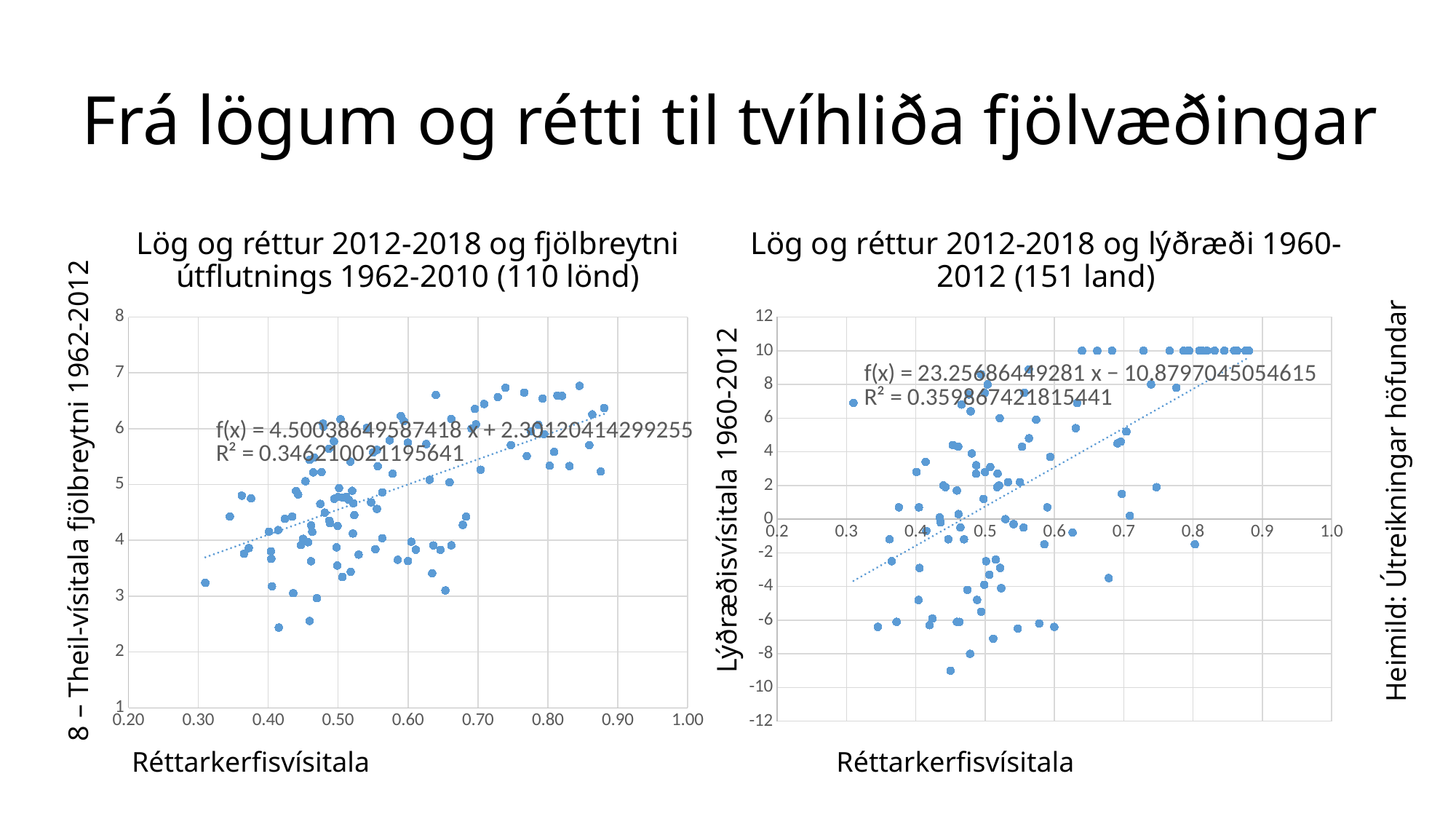
What kind of chart is the left chart, 'Lög og réttur 2012-2018 og fjölbreytni útflutnings 1962-2010 (110 lönd)'? Scatter chart What kind of chart is the right chart, 'Lög og réttur 2012-2018 og lýðræði 1960-2012 (151 land)'? Scatter chart In the right chart, what is the R² value shown for the trendline? R² = 0.359867421815441 Which chart has the higher R² value, the left chart or the right chart? The right chart In the right chart, do the values generally rise or fall as the Réttarkerfisvísitala increases along the x axis? Rise In the left chart, do the values generally rise or fall as the Réttarkerfisvísitala increases along the x axis? Rise In the left chart, what is the trendline equation shown? f(x) = 4.50038649587418 x + 2.30120414299255 In the right chart, how many countries (land) does the title say are plotted? 151 What is the x-axis label on both charts? Réttarkerfisvísitala In the left chart, what is the R² value shown for the trendline? R² = 0.346210021195641 In the right chart, what is the trendline equation shown? f(x) = 23.25686449281 x − 10.8797045054615 In the left chart, how many countries (lönd) does the title say are plotted? 110